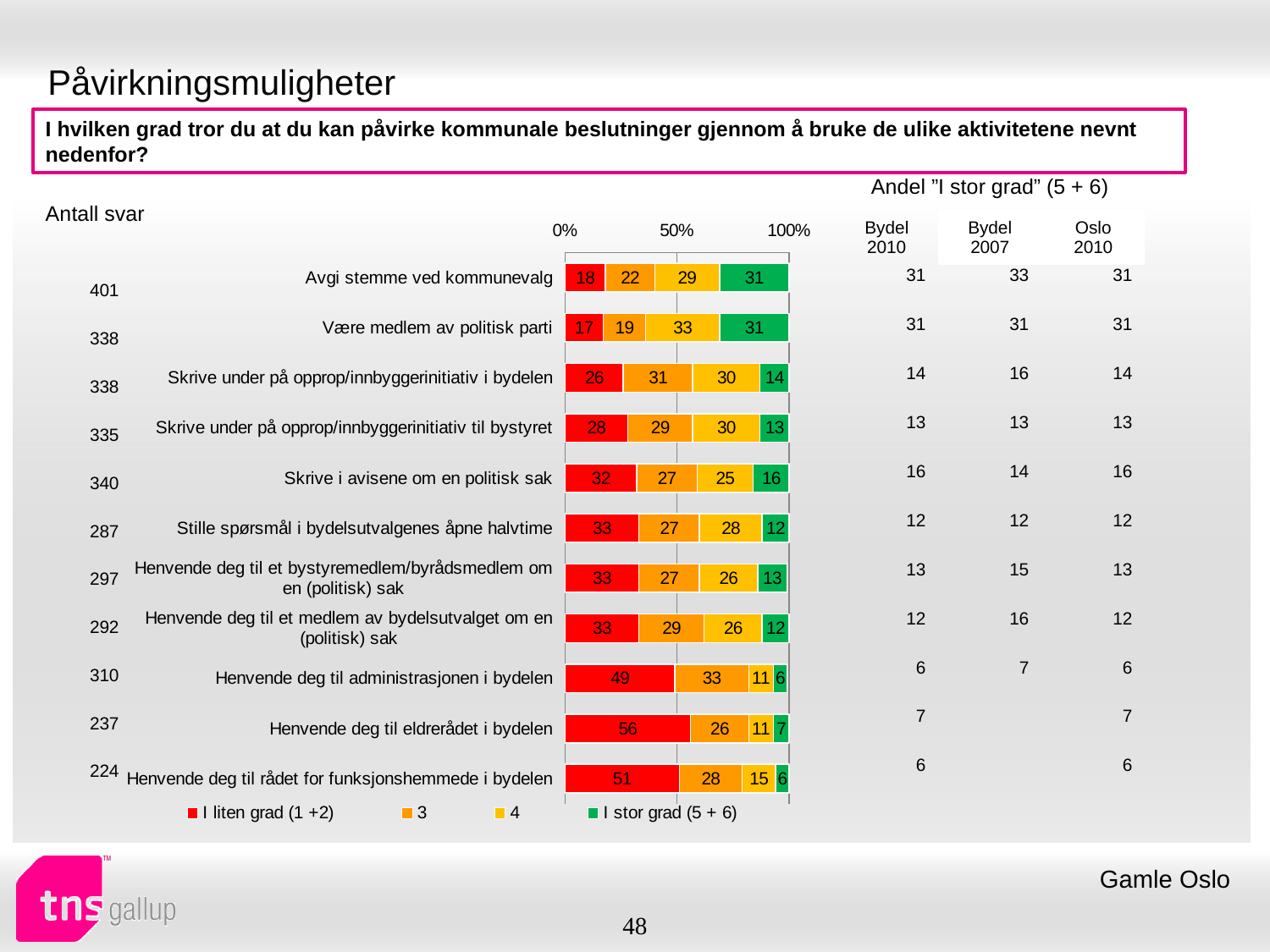
What is the difference between the "I liten grad (1 +2)" values for "Henvende deg til eldrerådet i bydelen" and "Henvende deg til administrasjonen i bydelen"? 7 What is the value of "I liten grad (1 +2)" for "Henvende deg til eldrerådet i bydelen"? 56 What kind of chart is shown on the slide? stacked bar chart Which activity has the lowest value for "I liten grad (1 +2)"? Være medlem av politisk parti Which colour represents "I stor grad (5 + 6)" in the chart? green What is the value of series "3" for "Skrive under på opprop/innbyggerinitiativ i bydelen"? 31 How many series does the chart legend list? 4 Which activity has the highest value for "I liten grad (1 +2)"? Henvende deg til eldrerådet i bydelen Which is larger: the "I stor grad (5 + 6)" value for "Skrive i avisene om en politisk sak" or for "Stille spørsmål i bydelsutvalgenes åpne halvtime"? Skrive i avisene om en politisk sak What is the value of series "4" for "Henvende deg til administrasjonen i bydelen"? 11 What is the value of "I stor grad (5 + 6)" for "Avgi stemme ved kommunevalg"? 31 How many activities (categories) are plotted in the chart? 11